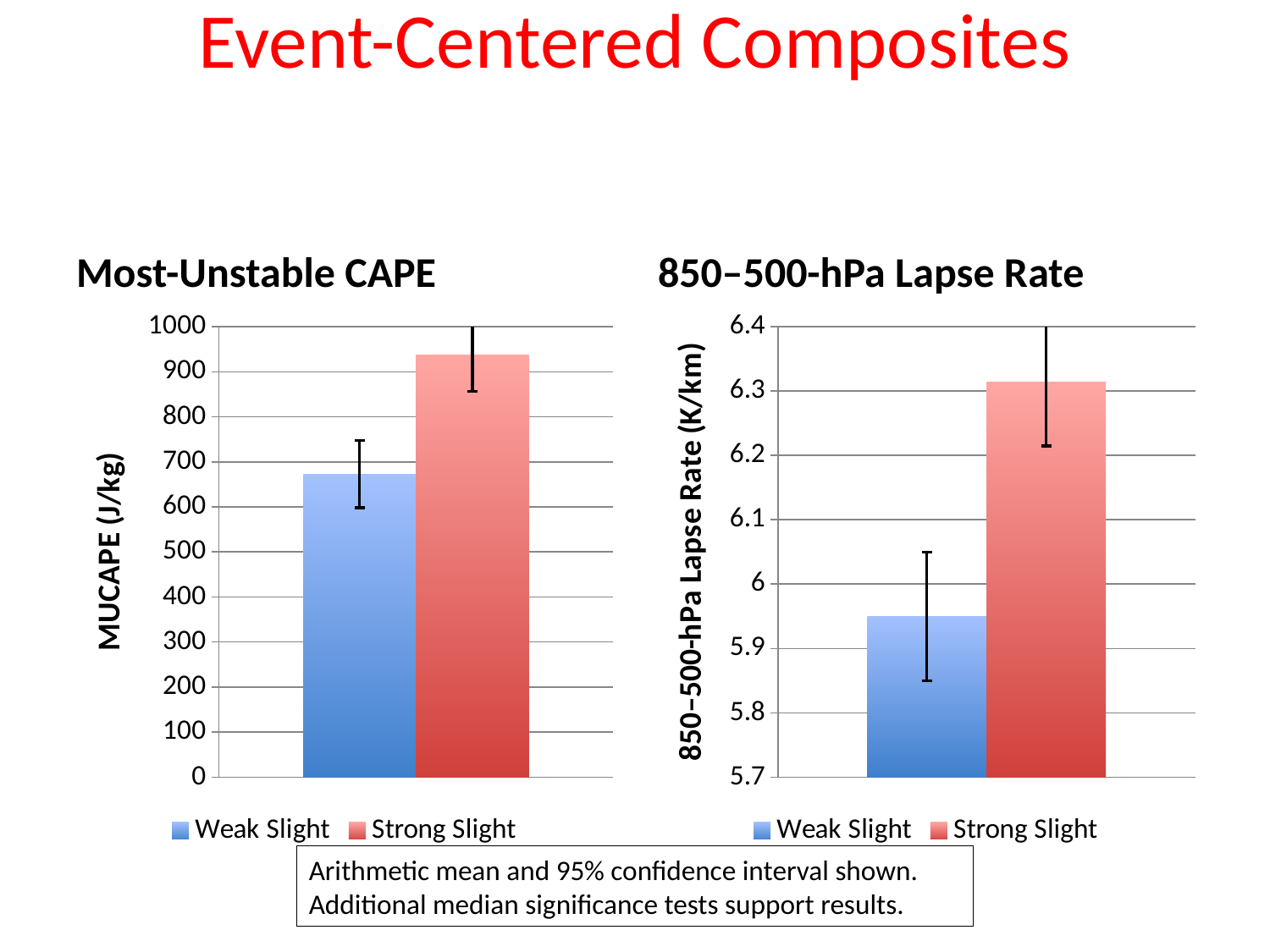
In the 850–500-hPa Lapse Rate chart, is the Weak Slight bar larger or smaller than the Strong Slight bar? smaller In the Most-Unstable CAPE chart, is the value for Strong Slight greater or less than 900? greater In the Most-Unstable CAPE chart, which series has the higher MUCAPE value? Strong Slight In the Most-Unstable CAPE chart, which series has the lower MUCAPE value? Weak Slight In the Most-Unstable CAPE chart, is the value for Weak Slight greater or less than 700? less What is the y-axis label of the Most-Unstable CAPE chart? MUCAPE (J/kg) In the 850–500-hPa Lapse Rate chart, is the value for Weak Slight greater or less than 6? less In the 850–500-hPa Lapse Rate chart, which series has the higher lapse rate? Strong Slight How many series does the legend of the Most-Unstable CAPE chart list? 2 What kind of chart is the 850–500-hPa Lapse Rate chart? bar chart